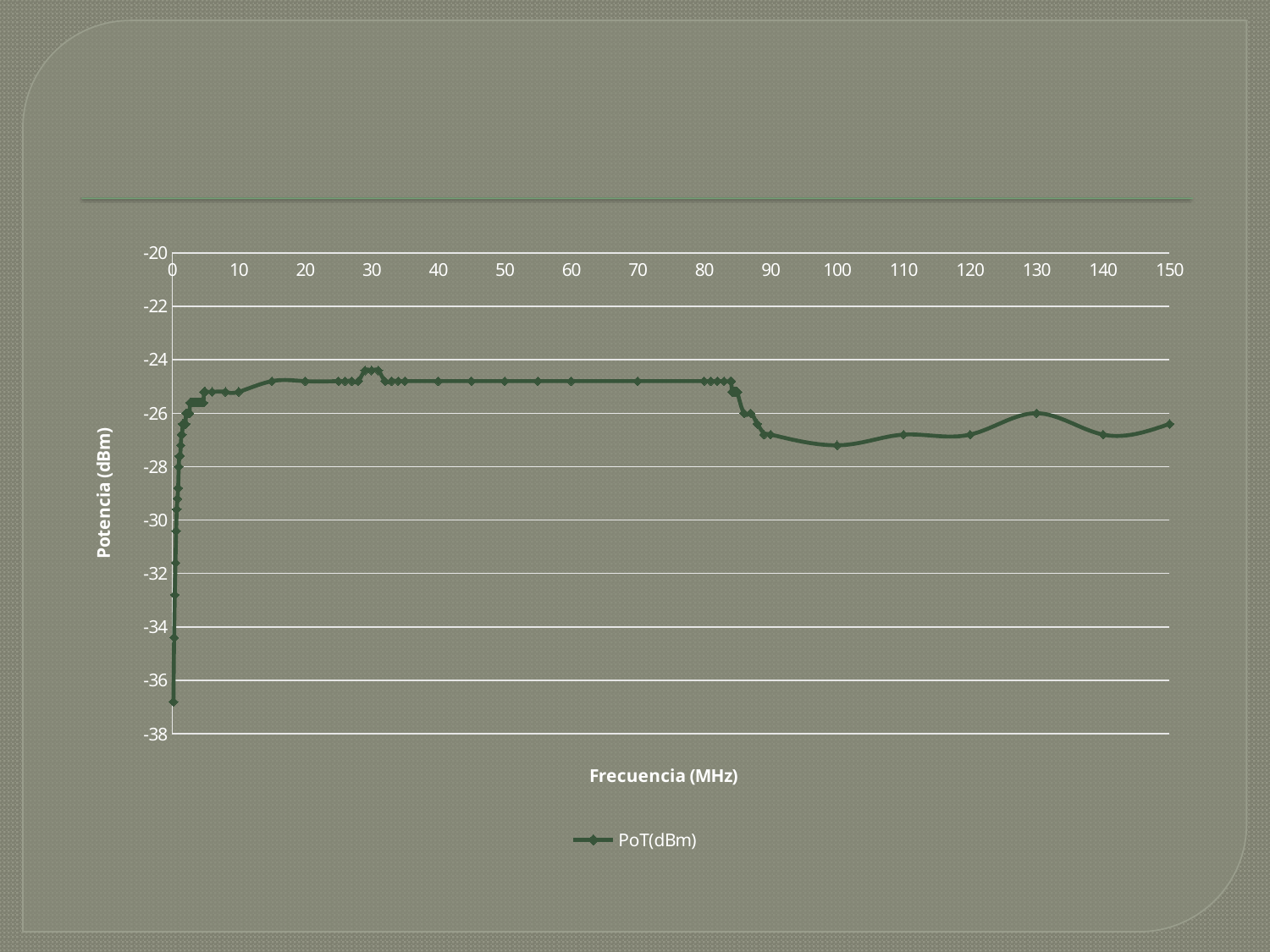
Is the value for PoT(dBm) at 50 MHz greater or less than -26? greater Does the PoT(dBm) line rise or fall between 0 MHz and 10 MHz? rise What is the title of the horizontal axis? Frecuencia (MHz) Is the value for PoT(dBm) at 140 MHz greater or less than -26? less Is the value for PoT(dBm) at 100 MHz greater or less than -28? greater Which is larger, the PoT(dBm) value at 50 MHz or at 100 MHz? 50 MHz What kind of chart is shown on the slide? line chart What is the name of the series shown in the legend? PoT(dBm) At which frequency does PoT(dBm) reach its lowest value? 0 MHz How many series does the legend list? 1